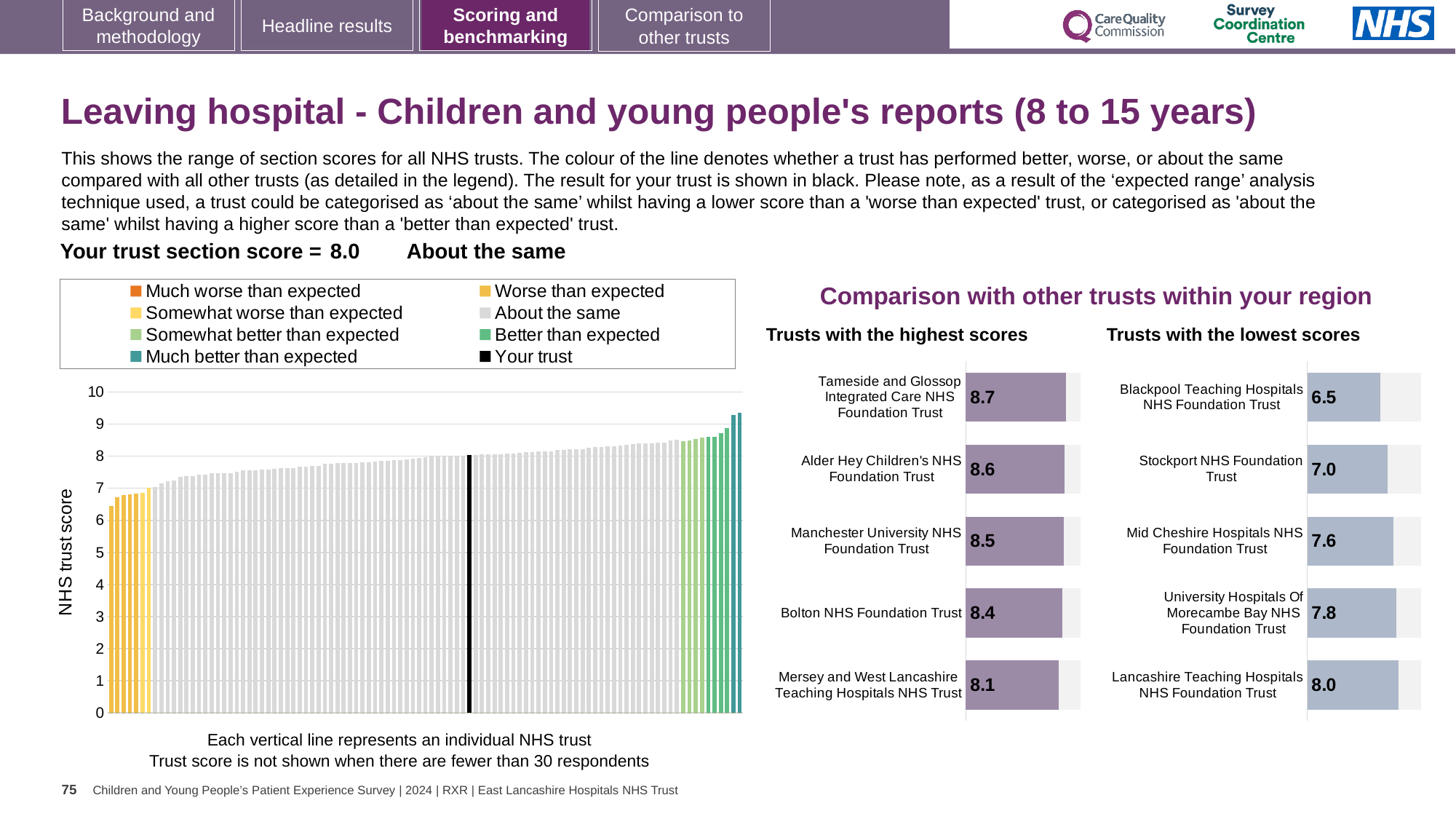
In the 'Trusts with the highest scores' chart, what is the score for Tameside and Glossop Integrated Care NHS Foundation Trust? 8.7 In the 'Trusts with the highest scores' chart, which trust has the lowest score shown? Mersey and West Lancashire Teaching Hospitals NHS Trust In the 'Trusts with the highest scores' chart, what is the score for Bolton NHS Foundation Trust? 8.4 What kind of chart is the large chart on the left showing the range of section scores for all NHS trusts? Bar chart In the 'Trusts with the lowest scores' chart, which trust has the lowest score? Blackpool Teaching Hospitals NHS Foundation Trust In the 'Trusts with the lowest scores' chart, what is the score for Blackpool Teaching Hospitals NHS Foundation Trust? 6.5 How many entries does the legend of the large chart on the left list? 8 In the 'Trusts with the highest scores' chart, what is the difference between the scores of Tameside and Glossop Integrated Care NHS Foundation Trust and Mersey and West Lancashire Teaching Hospitals NHS Trust? 0.6 How many trusts are listed in the 'Trusts with the highest scores' chart? 5 In the 'Trusts with the lowest scores' chart, which has the higher score: Stockport NHS Foundation Trust or Mid Cheshire Hospitals NHS Foundation Trust? Mid Cheshire Hospitals NHS Foundation Trust In the large chart on the left showing the range of section scores, is the value of the lowest bar greater or less than 7? less In the 'Trusts with the lowest scores' chart, what is the difference between the scores of Lancashire Teaching Hospitals NHS Foundation Trust and Blackpool Teaching Hospitals NHS Foundation Trust? 1.5